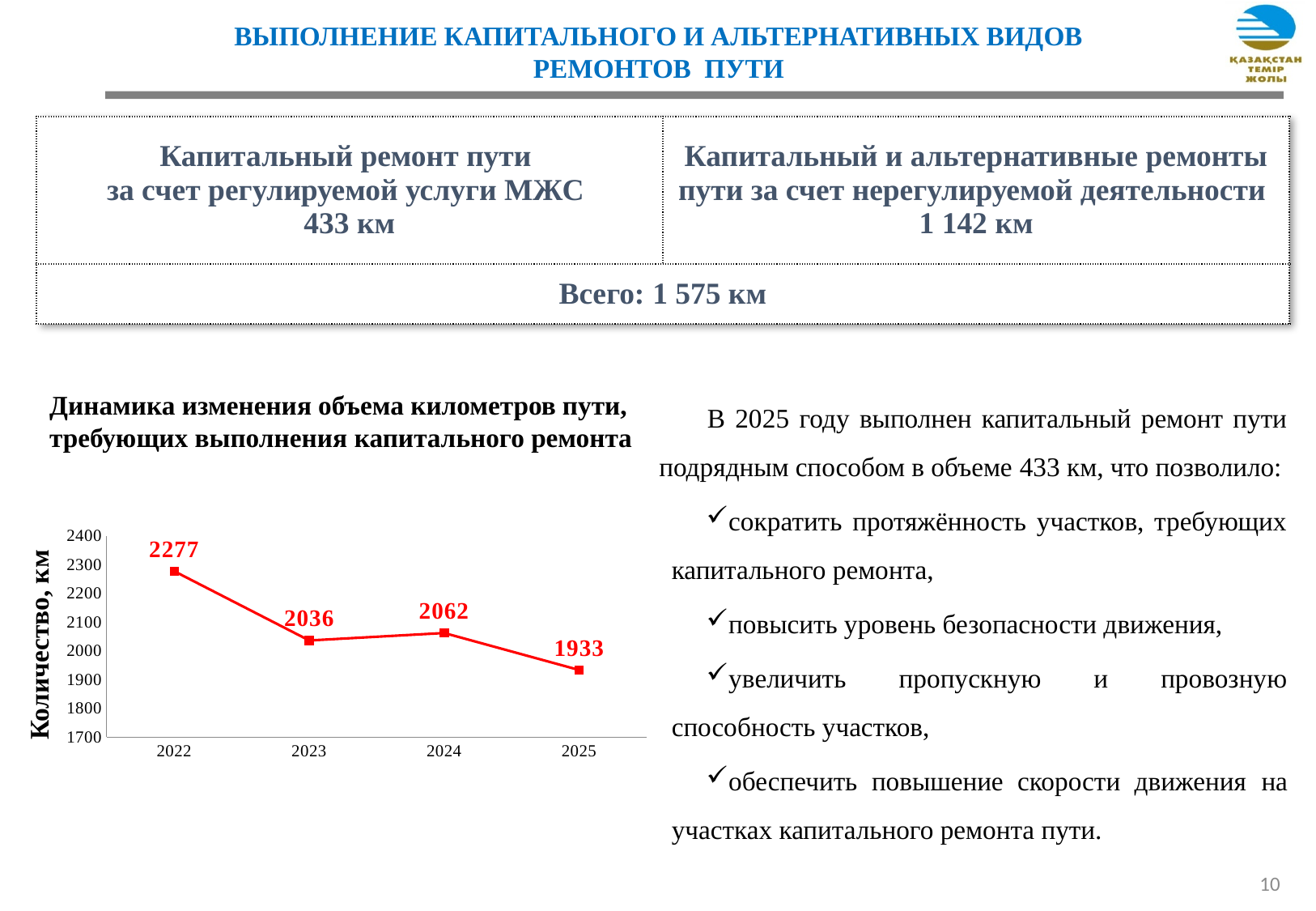
What is the difference between the values for 2024 and 2023 on the line chart? 26 What is the value for 2025 on the line chart? 1933 What is the value for 2024 on the line chart? 2062 Which year has the highest value on the line chart? 2022 Which year has the lowest value on the line chart? 2025 How many years are plotted on the line chart? 4 What is the label of the vertical axis of the line chart? Количество, км What is the difference between the values for 2022 and 2025 on the line chart? 344 Which is larger on the line chart, the value for 2023 or the value for 2024? 2024 What is the value for 2022 on the line chart? 2277 Is the value for 2025 on the line chart greater or less than 2000? less What kind of chart is shown on the slide? line chart